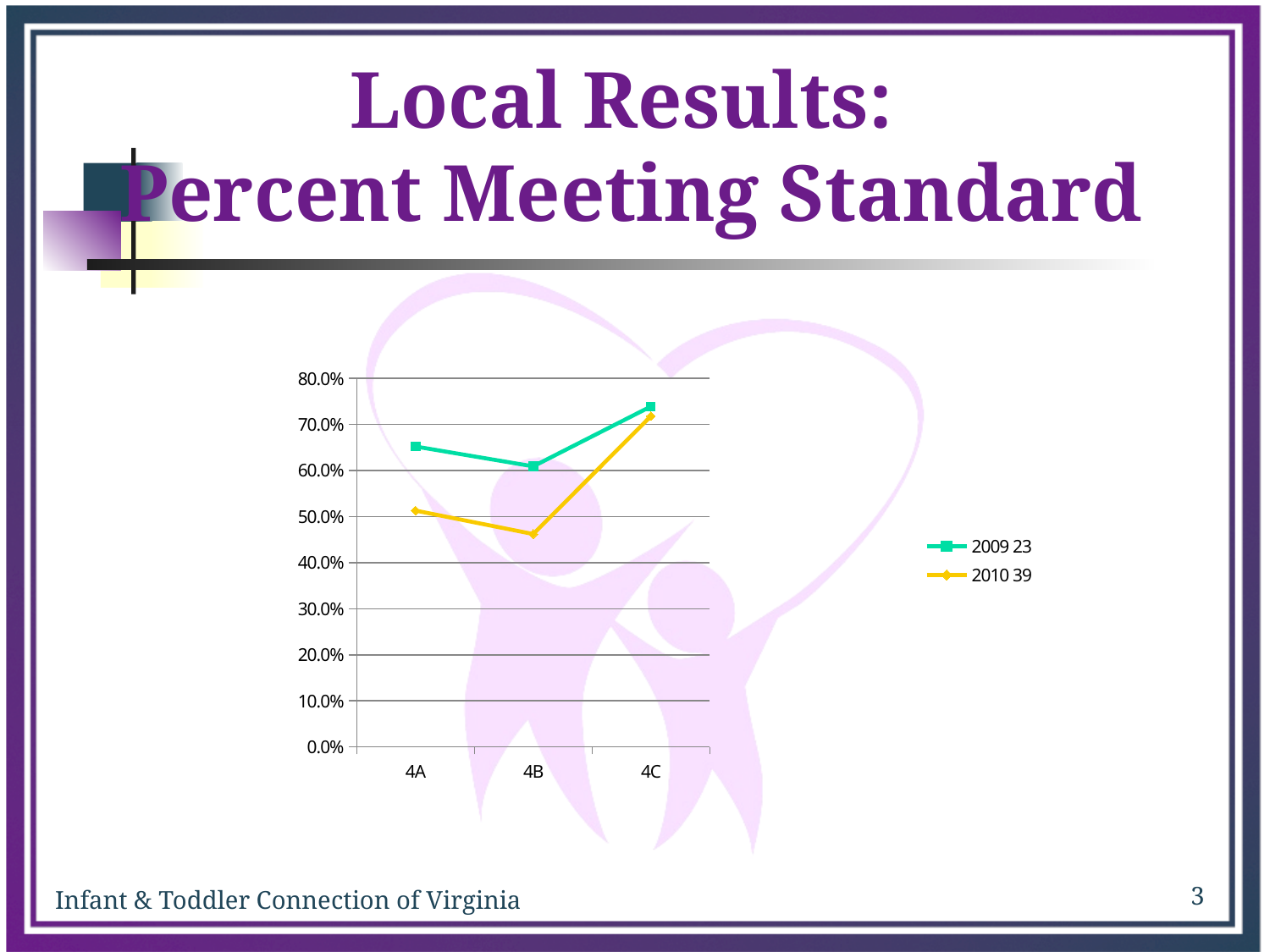
What kind of chart is shown on the slide? line chart Is the value for 4B in the 2010 39 series greater or less than 50.0%? less Which category has the lowest value for the 2009 23 series? 4B How many series does the chart's legend list? 2 Which category has the highest value for the 2010 39 series? 4C How many categories are shown on the x axis of the chart? 3 For category 4A, which series has the larger value, 2009 23 or 2010 39? 2009 23 Is the value for 4C in the 2009 23 series greater or less than 70.0%? greater Which category has the lowest value for the 2010 39 series? 4B What are the two series names listed in the chart's legend? 2009 23 and 2010 39 Does the 2010 39 series rise or fall from 4B to 4C? rise Which category has the highest value for the 2009 23 series? 4C